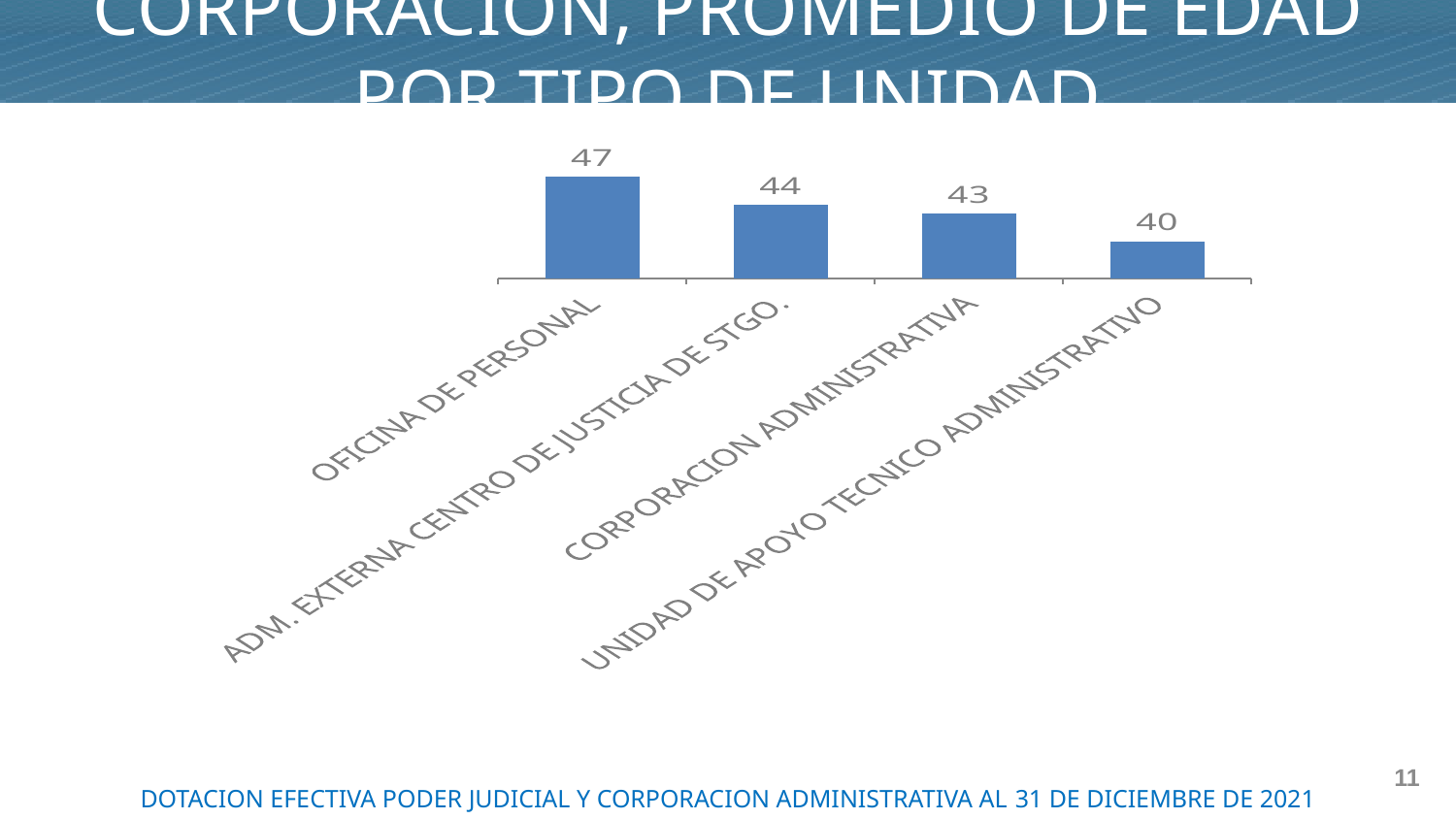
What is the difference in average age between ADM. EXTERNA CENTRO DE JUSTICIA DE STGO. and CORPORACION ADMINISTRATIVA? 1 Do the values rise or fall from left to right across the chart? Fall Which has a higher average age, OFICINA DE PERSONAL or CORPORACION ADMINISTRATIVA? OFICINA DE PERSONAL What is the average age shown for OFICINA DE PERSONAL? 47 Which unit type has the lowest average age? UNIDAD DE APOYO TECNICO ADMINISTRATIVO What kind of chart is shown on the slide? Bar chart Which unit type has the highest average age? OFICINA DE PERSONAL What is the difference in average age between OFICINA DE PERSONAL and UNIDAD DE APOYO TECNICO ADMINISTRATIVO? 7 What is the average age shown for UNIDAD DE APOYO TECNICO ADMINISTRATIVO? 40 What is the average age shown for CORPORACION ADMINISTRATIVA? 43 How many unit types are shown in the chart? 4 What is the average age shown for ADM. EXTERNA CENTRO DE JUSTICIA DE STGO.? 44